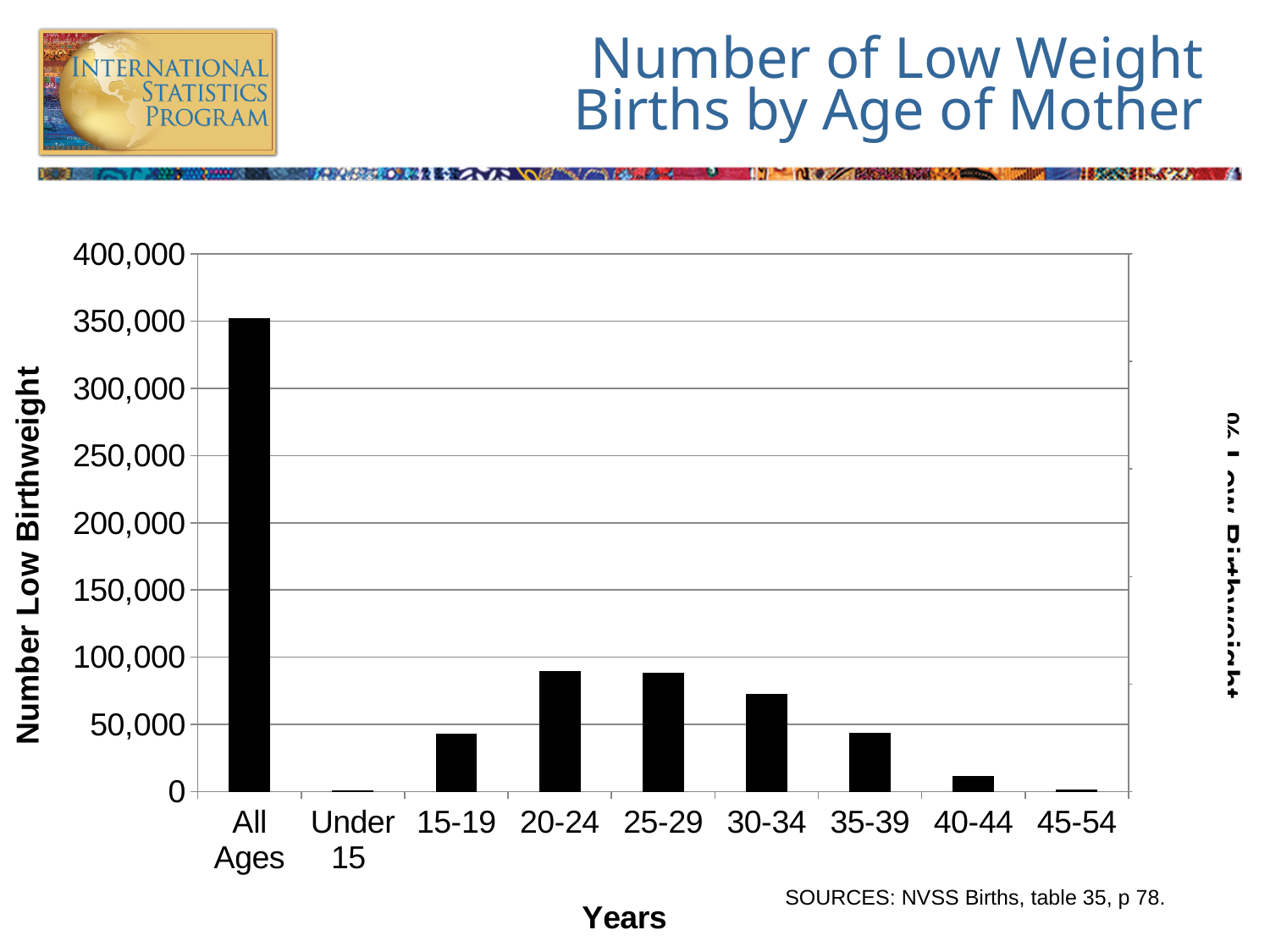
Is the value for 30-34 greater or less than 50,000? greater Is the value for 40-44 greater or less than 50,000? less Is the value for 20-24 greater or less than 50,000? greater Which has more low weight births, 40-44 or 25-29? 25-29 Which category has the highest number of low weight births? All Ages How many categories are shown on the x axis of the chart? 9 Which has more low weight births, 30-34 or 35-39? 30-34 Do the values rise or fall across the age groups from 20-24 to 45-54? fall What kind of chart is shown on the slide? bar chart What is the label of the y axis of the chart? Number Low Birthweight